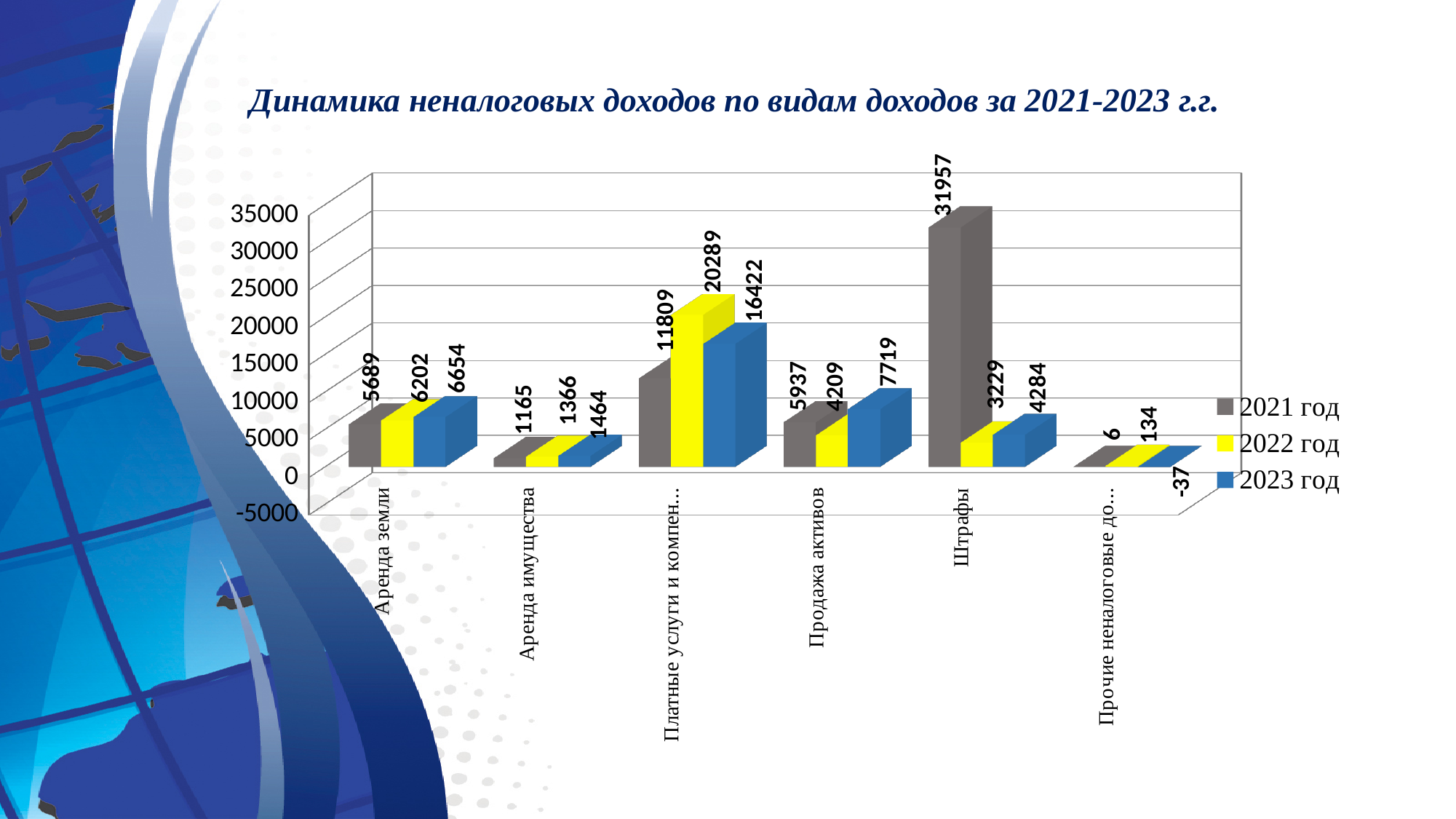
What is the difference between the 2022 год and 2021 год values for Платные услуги и компен...? 8480 How many categories are shown on the x axis? 6 How many series does the legend list? 3 Do the values for Аренда имущества rise or fall from 2021 год to 2023 год? rise What kind of chart is shown on the slide? bar chart Which is larger for Продажа активов: the 2021 год value or the 2023 год value? 2023 год Which category has the highest value in the 2022 год series? Платные услуги и компен... Which category has the lowest value in the 2023 год series? Прочие неналоговые до... What is the value for Штрафы in the 2021 год series? 31957 What is the value for Продажа активов in the 2022 год series? 4209 What is the difference between the 2021 год and 2022 год values for Штрафы? 28728 What is the value for Аренда земли in the 2023 год series? 6654